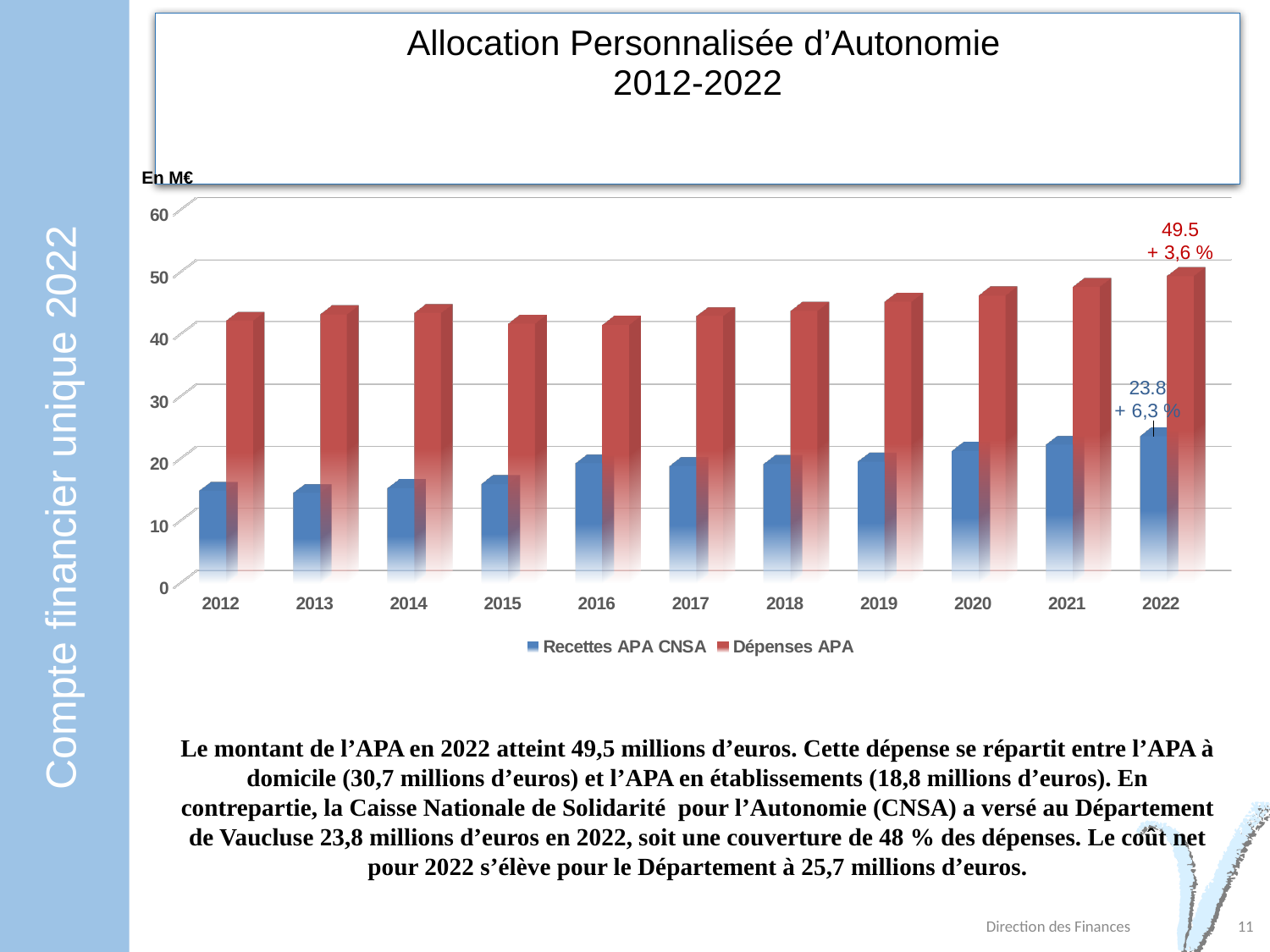
In which year is Recettes APA CNSA highest? 2022 In which year is Dépenses APA highest? 2022 How many years are shown on the x axis of the chart? 11 Is the value of Dépenses APA for 2012 greater or less than 40? greater What kind of chart is shown on the slide? bar chart How many series does the legend list? 2 What is the difference between Dépenses APA and Recettes APA CNSA in 2022? 25.7 What is the value of Dépenses APA for 2022? 49.5 Is the value of Recettes APA CNSA for 2012 greater or less than 20? less In 2022, which is larger: Dépenses APA or Recettes APA CNSA? Dépenses APA What is the value of Recettes APA CNSA for 2022? 23.8 Is the value of Dépenses APA for 2021 greater or less than 50? less